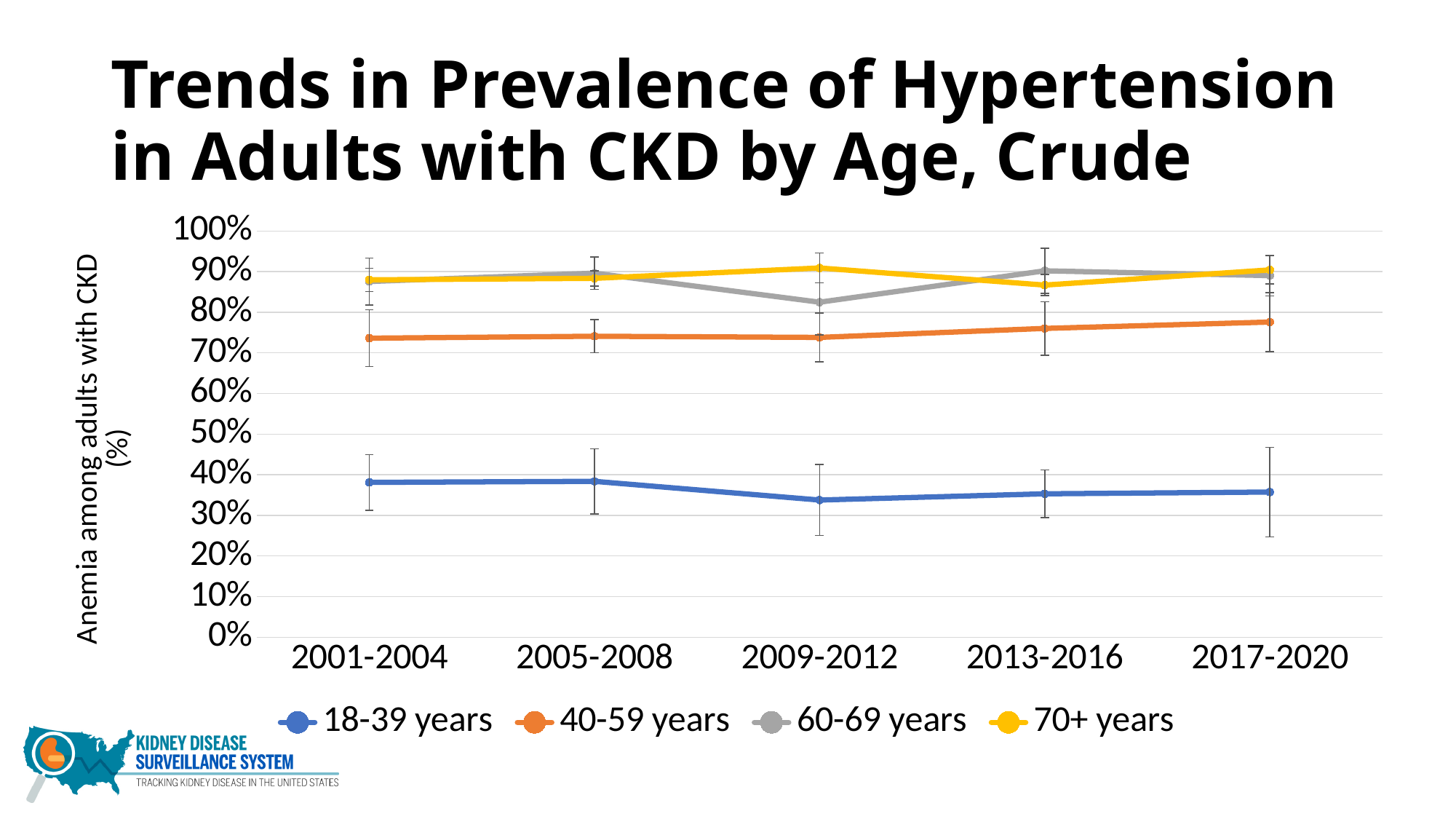
What is the label on the y axis? Anemia among adults with CKD (%) Does the value for 18-39 years rise or fall from 2005-2008 to 2009-2012? fall How many series does the legend list? 4 Is the value for 70+ years in 2009-2012 greater or less than 80%? greater Which age group has the lowest values across all time periods? 18-39 years How many time periods are shown on the x axis? 5 Is the value for 18-39 years in 2009-2012 greater or less than 40%? less In 2009-2012, which is larger: the value for 60-69 years or the value for 70+ years? 70+ years Is the value for 60-69 years in 2009-2012 greater or less than 90%? less Which age group has the highest value in 2009-2012? 70+ years What kind of chart is shown on the slide? line chart